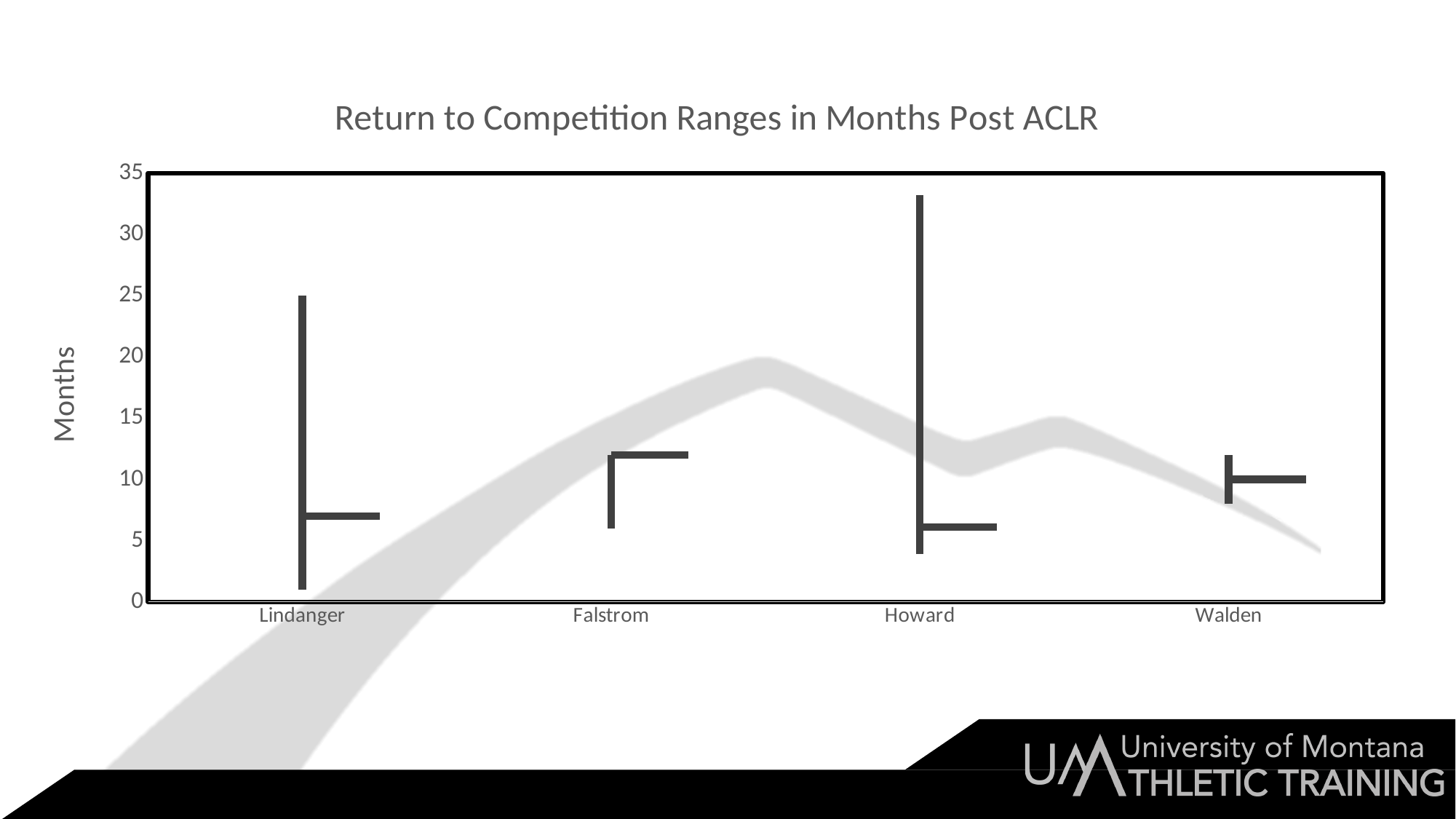
Is the upper end of Howard's range greater or less than 30? greater How many categories are shown on the x axis? 4 Which category has the highest upper end of its range? Howard What is the title of the chart? Return to Competition Ranges in Months Post ACLR Is the upper end of Lindanger's range greater or less than 20? greater Which category has the lowest lower end of its range? Lindanger Which category has the widest range? Howard Is the upper end of Falstrom's range greater or less than 15? less What is the maximum value shown on the vertical axis? 35 What is the label on the vertical axis? Months Which has a higher upper end of its range, Lindanger or Falstrom? Lindanger